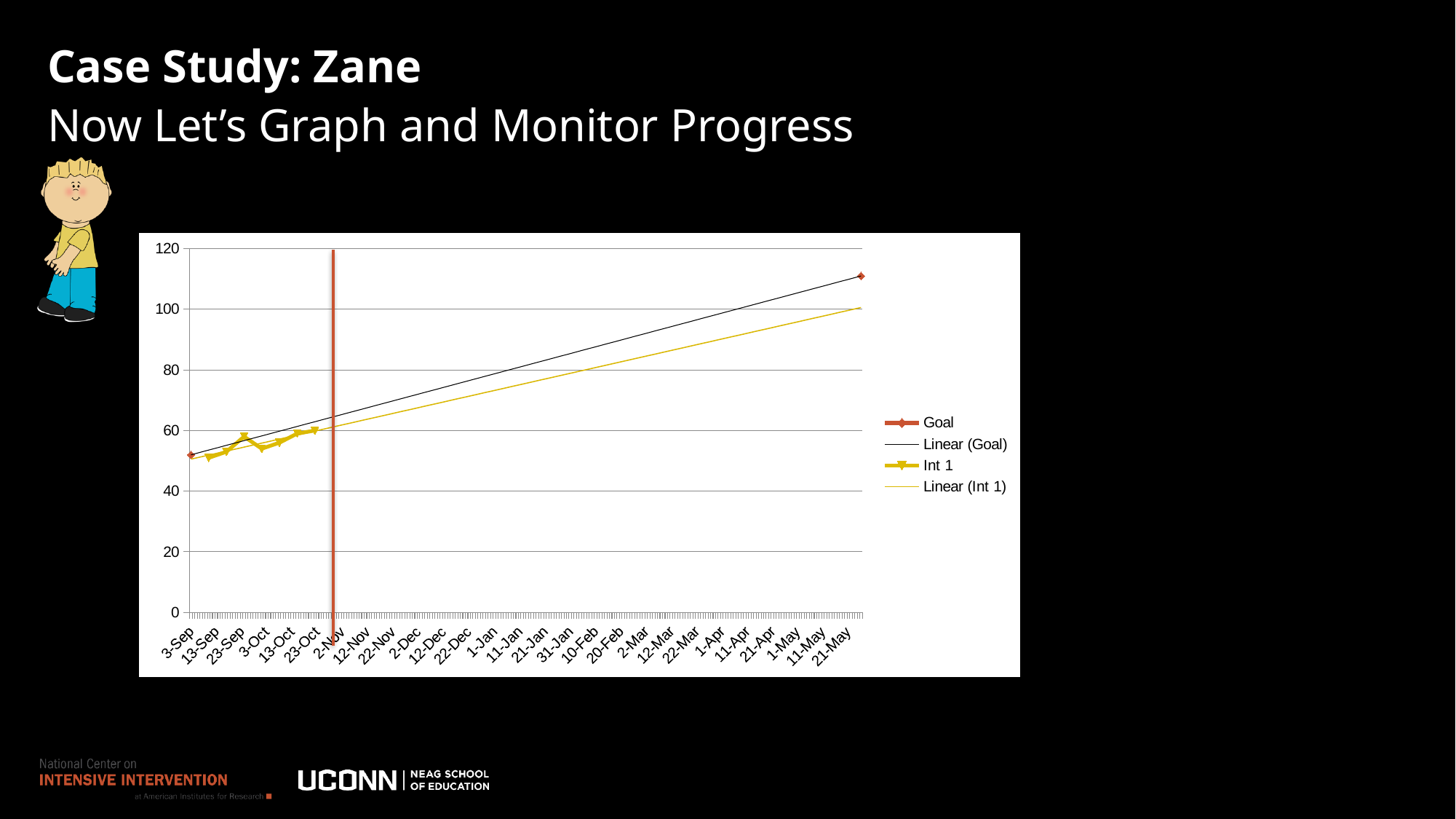
What is the highest value shown on the chart's vertical axis? 120 What kind of chart is shown on the slide? Line chart Which is larger: the Goal value at 21-May or the Int 1 value at 23-Oct? Goal value at 21-May What is the last date label on the chart's horizontal axis? 21-May Do the Int 1 values generally rise or fall from 3-Sep to 23-Oct? rise What is the first date label on the chart's horizontal axis? 3-Sep How many series does the chart's legend list? 4 Is the Goal value at 21-May greater or less than 100? greater What are the entries listed in the chart's legend? Goal, Linear (Goal), Int 1, Linear (Int 1) Is the highest Int 1 data point greater or less than 80? less Is the Linear (Goal) trend line at 21-May greater or less than 100? greater